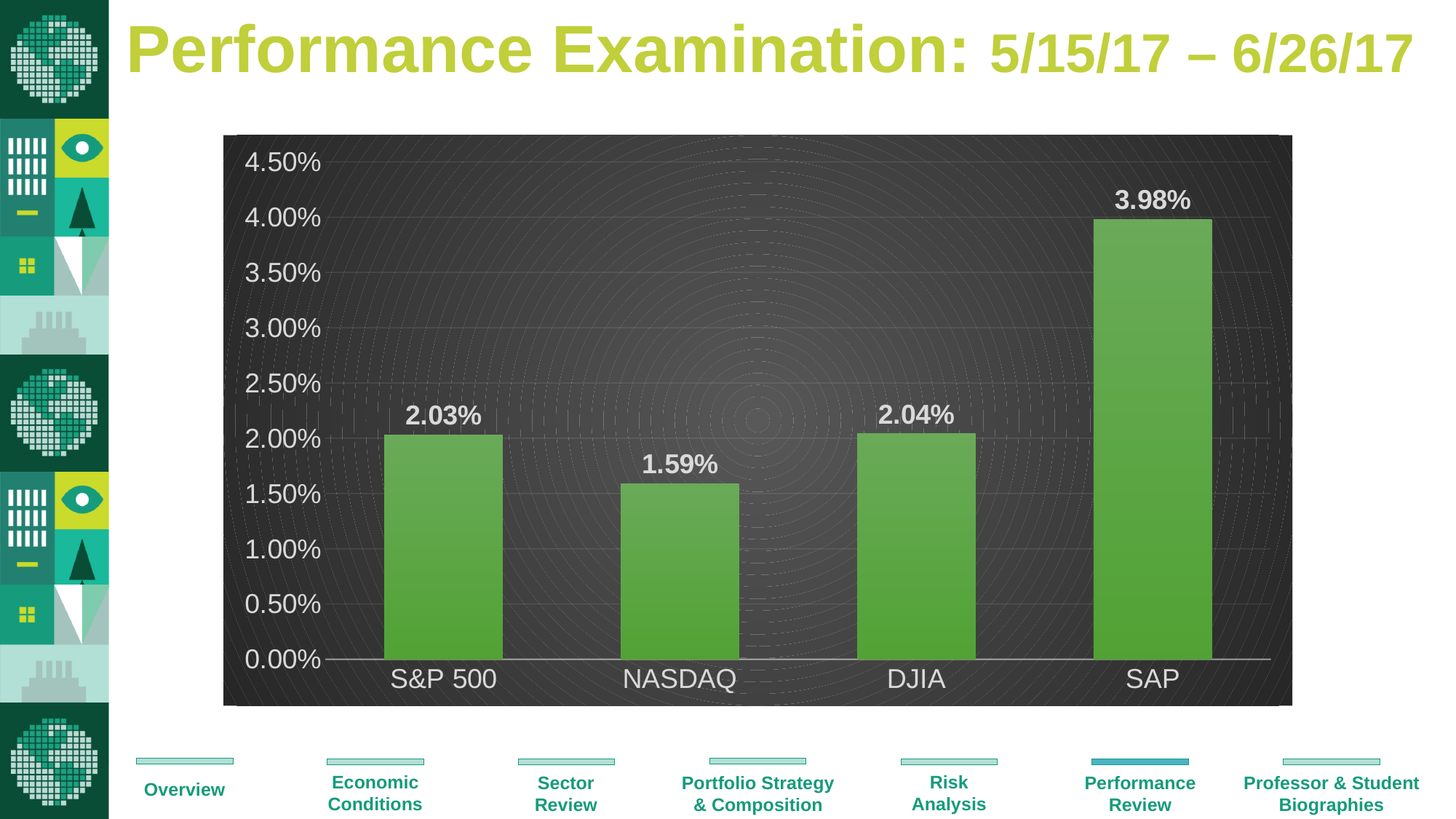
What is the value for DJIA? 2.04% Which category has the lowest value? NASDAQ How many categories are shown on the x axis? 4 What is the value for SAP? 3.98% Which category has the highest value? SAP What is the value for S&P 500? 2.03% What kind of chart is shown on the slide? bar chart Which is larger, the value for SAP or the value for DJIA? SAP What is the value for NASDAQ? 1.59% What is the difference between the values for DJIA and NASDAQ? 0.45% Is the value for NASDAQ greater or less than 2.00%? less What is the difference between the values for SAP and NASDAQ? 2.39%